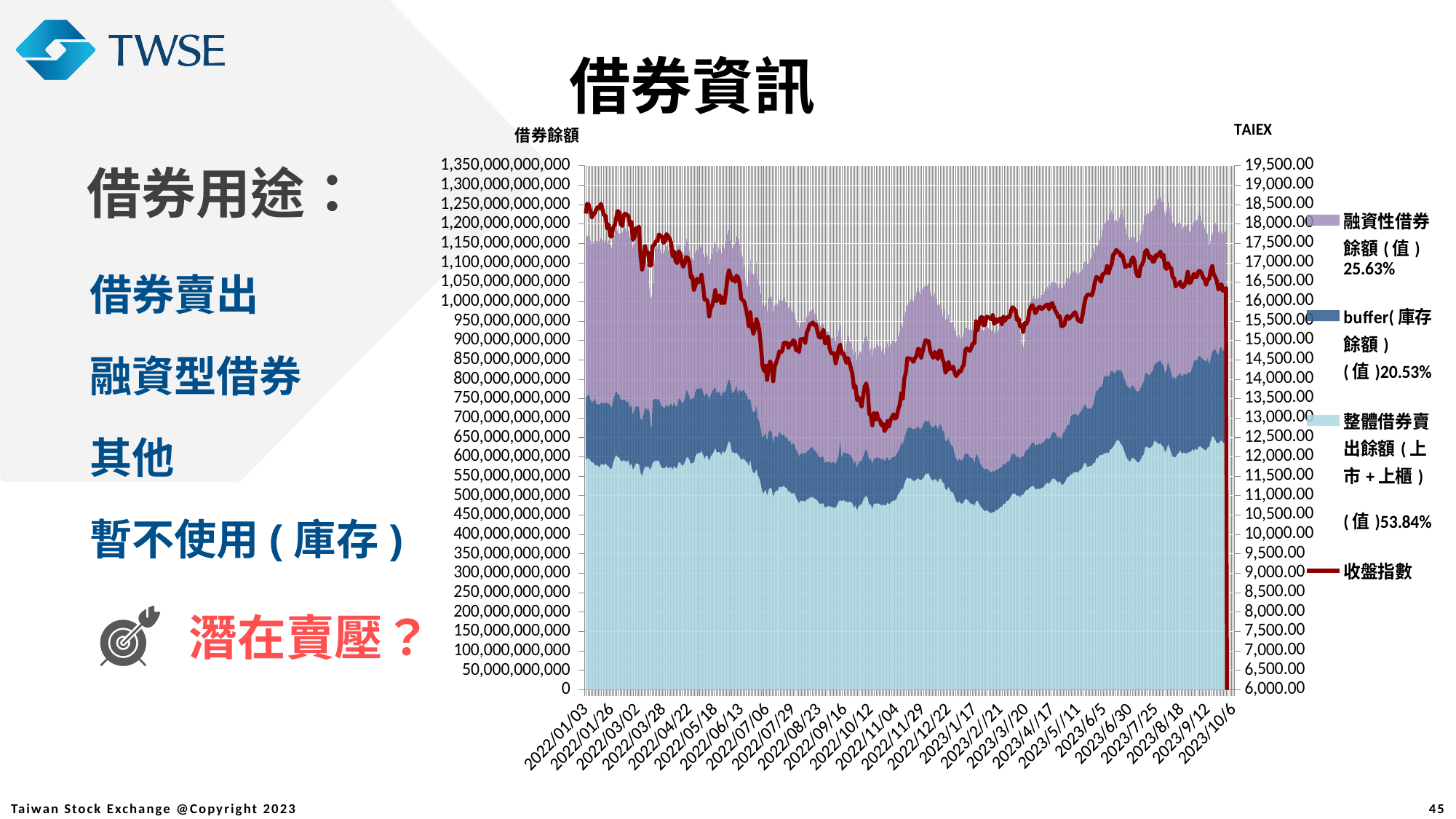
Which has the larger percentage in the legend, 融資性借券餘額 or buffer (庫存餘額)? 融資性借券餘額 What percentage is shown in the legend for 融資性借券餘額 (值)? 25.63% Is the 收盤指數 (TAIEX) value at 2022/01/03 greater or less than 17,500.00? greater What percentage is shown in the legend for 整體借券賣出餘額 (上市+上櫃) (值)? 53.84% What kind of chart is used to show the 借券餘額 series? Stacked area chart (with a line for 收盤指數) What percentage is shown in the legend for buffer (庫存餘額) (值)? 20.53% What is the difference in percentage points between 整體借券賣出餘額 (53.84%) and 融資性借券餘額 (25.63%)? 28.21 What is the title of the right-hand vertical axis? TAIEX Is the lowest point of the 收盤指數 line (around 2022/10–11) greater or less than 13,500.00? less Which legend series has the highest percentage share? 整體借券賣出餘額 (上市+上櫃) How many series does the chart legend list? 4 Does the 收盤指數 line rise or fall from 2022/01/03 to 2022/10/12? fall